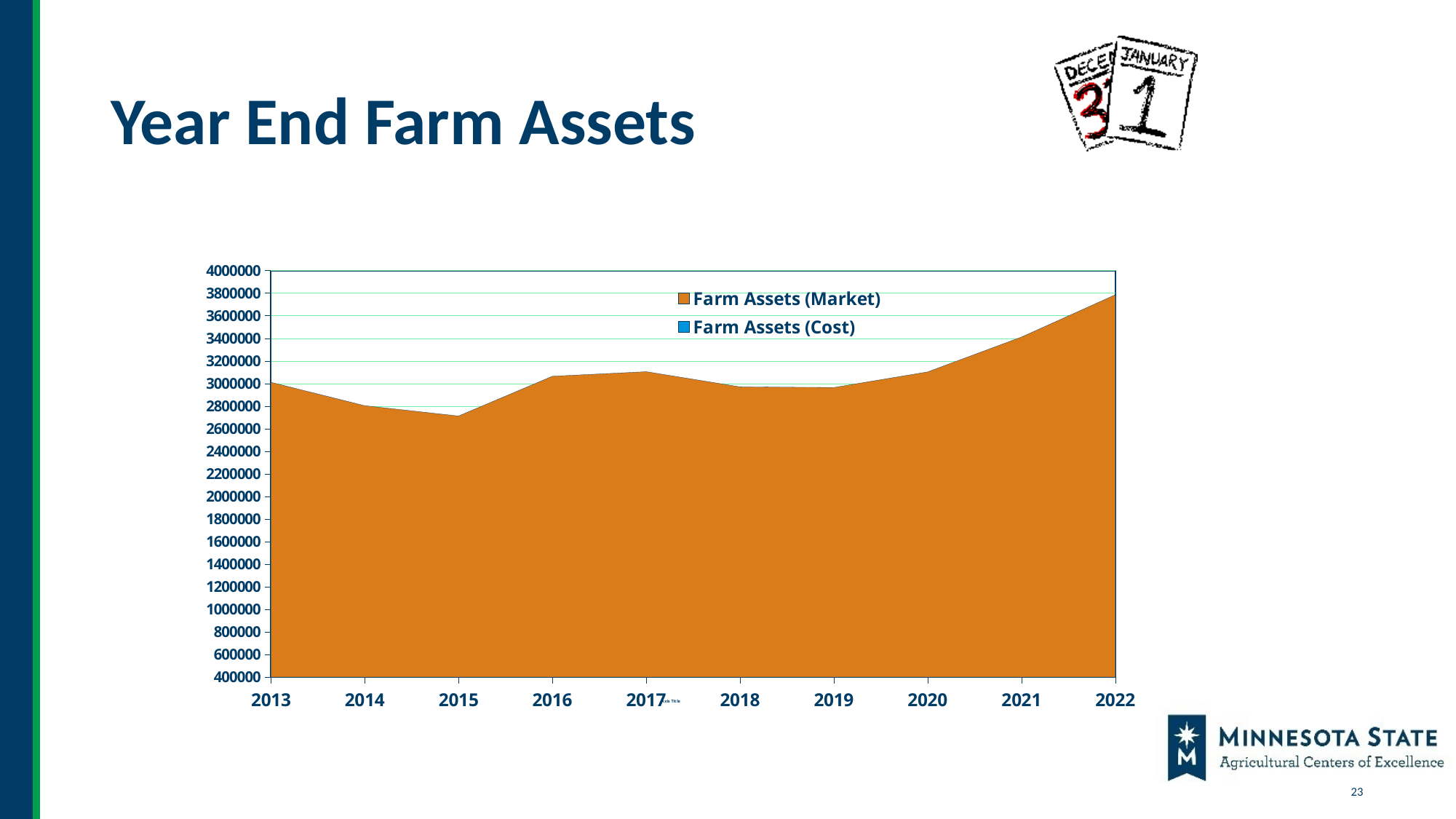
Is the value for Farm Assets (Market) in 2015 greater or less than 2800000? less What colour represents Farm Assets (Market) in the chart? orange How many years are shown along the x axis of the chart? 10 Is the value for Farm Assets (Market) in 2022 greater or less than 3600000? greater What kind of chart is shown on the slide? area chart In which year is Farm Assets (Market) highest? 2022 Do Farm Assets (Market) values rise or fall from 2019 to 2022? rise In which year is Farm Assets (Market) lowest? 2015 Which year has the larger Farm Assets (Market) value, 2013 or 2021? 2021 Is the value for Farm Assets (Market) in 2014 greater or less than 3000000? less How many series does the chart's legend list? 2